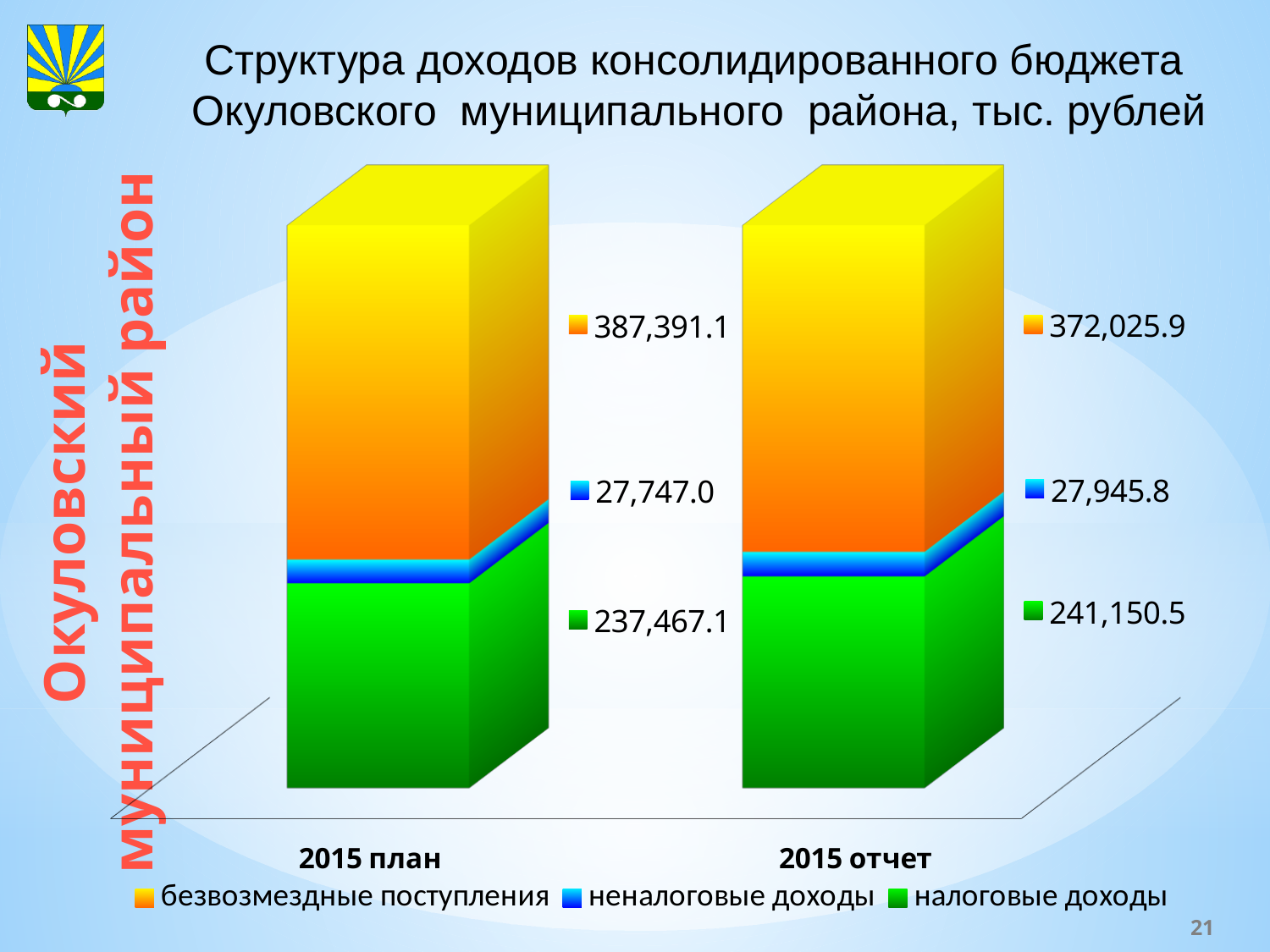
What is the value of безвозмездные поступления for 2015 план? 387,391.1 What is the value of безвозмездные поступления for 2015 отчет? 372,025.9 How many categories are shown on the x axis? 2 What is the total of the 2015 отчет stacked bar? 641,122.2 Which series has the smallest value in the 2015 отчет bar? неналоговые доходы What type of chart is shown on the slide? Stacked bar chart Which series has the largest value in the 2015 план bar? безвозмездные поступления What is the difference between безвозмездные поступления for 2015 план and 2015 отчет? 15,365.2 What is the value of налоговые доходы for 2015 план? 237,467.1 How many series does the legend list? 3 What is the value of неналоговые доходы for 2015 отчет? 27,945.8 Which is larger: налоговые доходы for 2015 план or for 2015 отчет? 2015 отчет